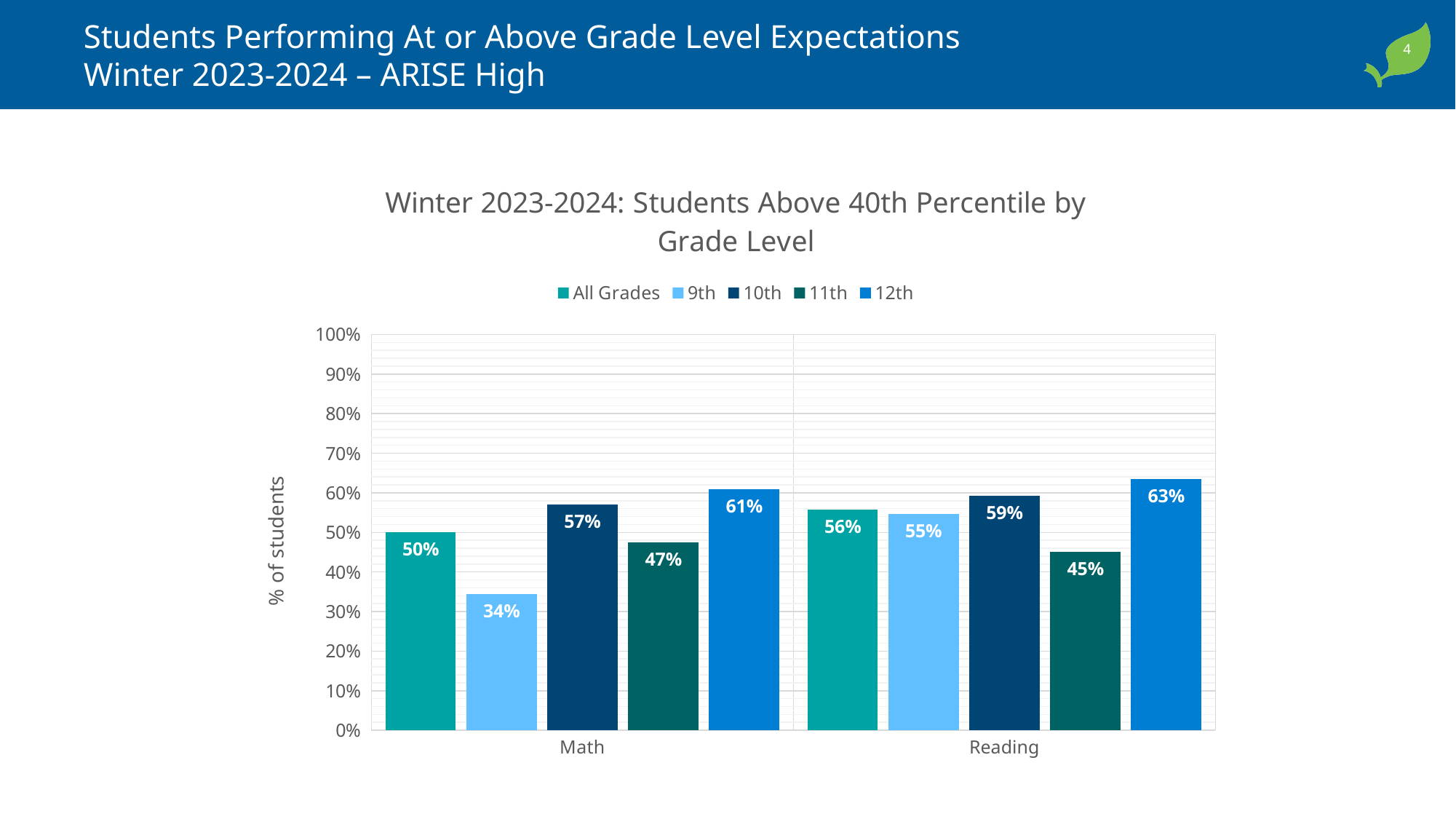
How many categories are shown on the x axis? 2 How many series does the legend list? 5 What is the value for All Grades in Reading? 56% What kind of chart is shown on the slide? bar chart Which grade series has the lowest value in Reading? 11th What is the value for 9th grade in Math? 34% What is the value for 12th grade in Reading? 63% What is the label of the y axis? % of students Which grade series has the highest value in Math? 12th Is the value for 11th grade in Math greater or less than 50%? less Which is larger, the 10th grade value in Math or the 10th grade value in Reading? Reading What is the difference between the 12th grade and 9th grade values in Math? 27%